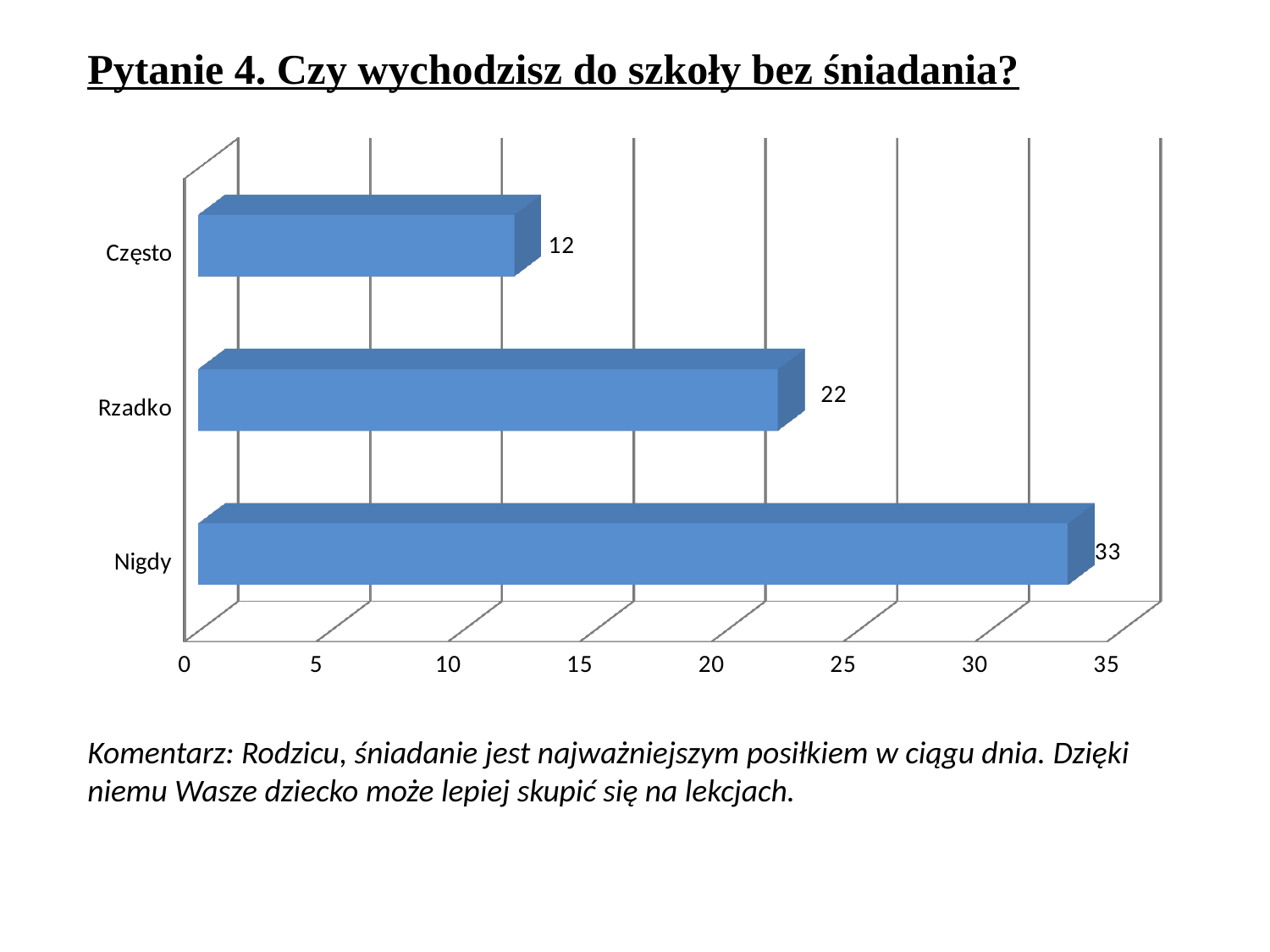
How many categories are shown in the chart? 3 What kind of chart is shown on the slide? bar chart What is the value for Rzadko? 22 What is the difference between the values for Rzadko and Często? 10 What is the difference between the values for Nigdy and Rzadko? 11 Is the value for Nigdy greater or less than 30? greater Which category has the lowest value? Często Which is larger, the value for Rzadko or the value for Często? Rzadko What is the title of the slide above the chart? Pytanie 4. Czy wychodzisz do szkoły bez śniadania? Which category has the highest value? Nigdy What is the value for Często? 12 What is the value for Nigdy? 33